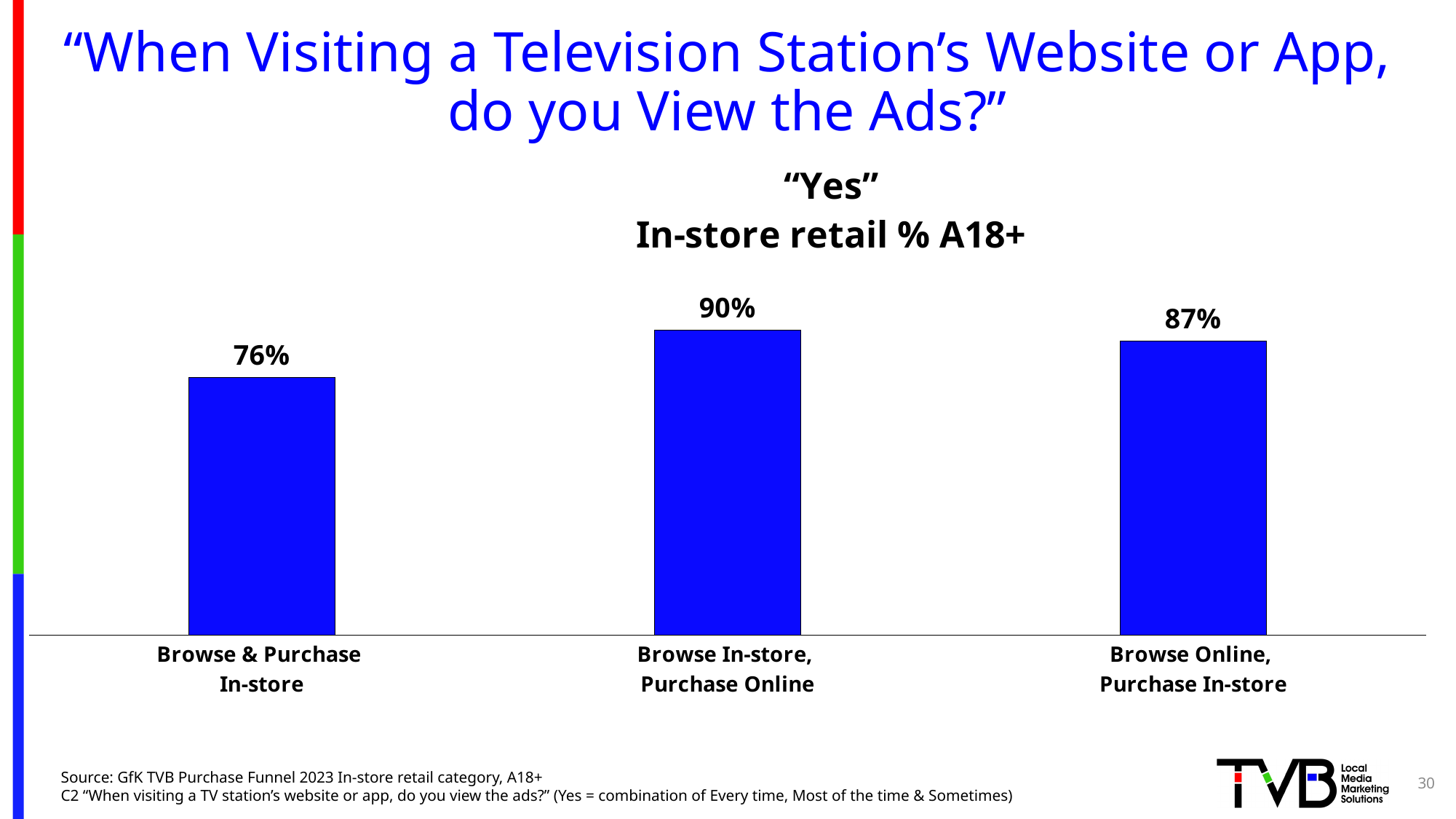
How many categories are shown in the chart? 3 What is the value for Browse In-store, Purchase Online? 90% What kind of chart is shown on the slide? Bar chart Which category has the highest value? Browse In-store, Purchase Online Which category has the lowest value? Browse & Purchase In-store What is the difference between the values for Browse In-store, Purchase Online and Browse & Purchase In-store? 14 percentage points What is the value for Browse & Purchase In-store? 76% What is the difference between the values for Browse In-store, Purchase Online and Browse Online, Purchase In-store? 3 percentage points Which is larger: the value for Browse Online, Purchase In-store or the value for Browse & Purchase In-store? Browse Online, Purchase In-store What is the value for Browse Online, Purchase In-store? 87% What colour are the bars in the chart? Blue What is the title of the chart? "Yes" In-store retail % A18+